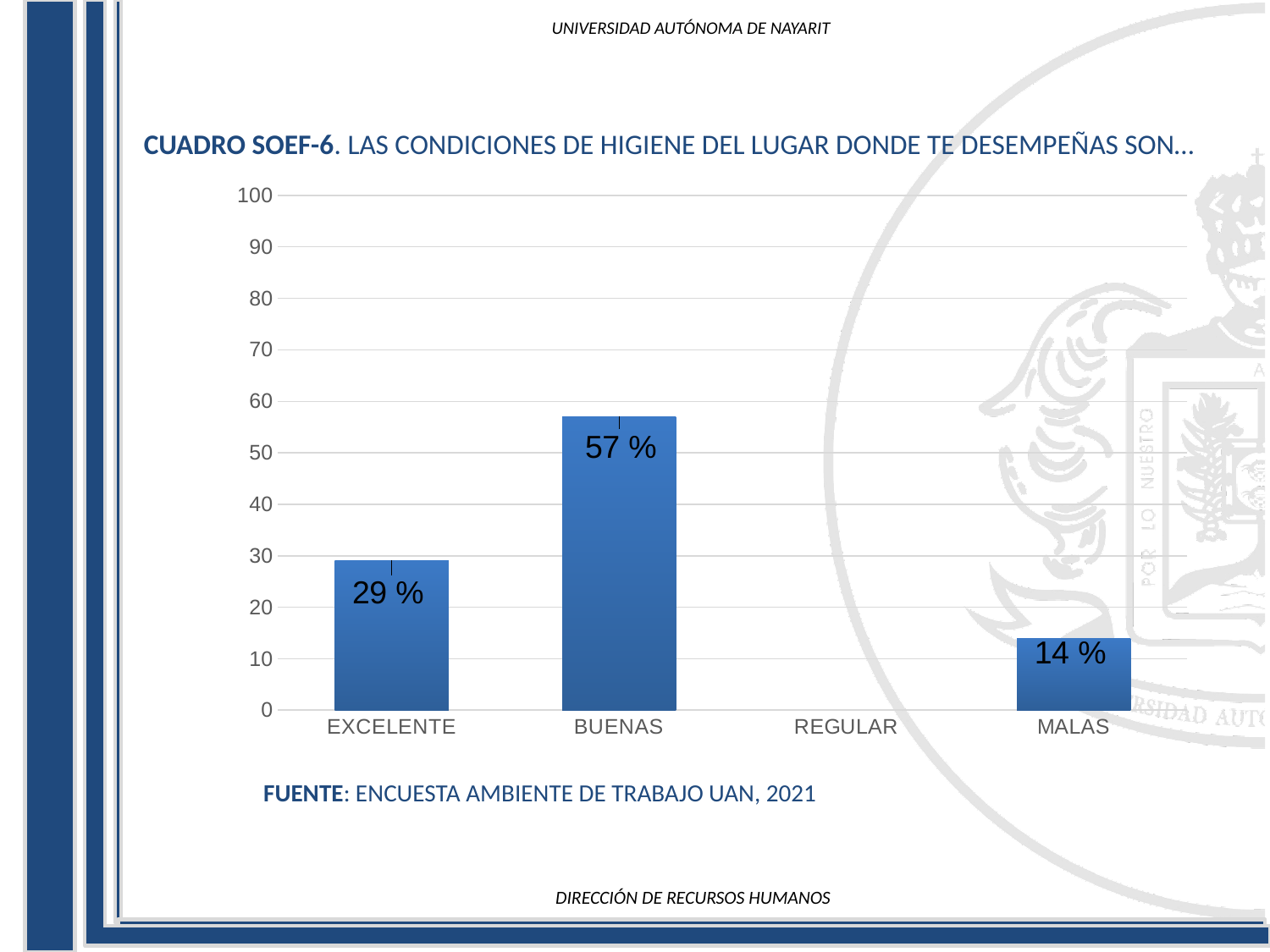
What is the value shown for BUENAS? 57 % Which is larger, the value for EXCELENTE or the value for MALAS? EXCELENTE Which category has the highest value? BUENAS How many categories are shown on the x axis? 4 Is the value for BUENAS greater or less than 50? greater What is the difference between the values for BUENAS and EXCELENTE? 28 % What source is cited below the chart? ENCUESTA AMBIENTE DE TRABAJO UAN, 2021 Which category has the shortest visible bar? MALAS What is the value shown for EXCELENTE? 29 % What is the difference between the values for EXCELENTE and MALAS? 15 % What kind of chart is shown on the slide? bar chart What is the value shown for MALAS? 14 %